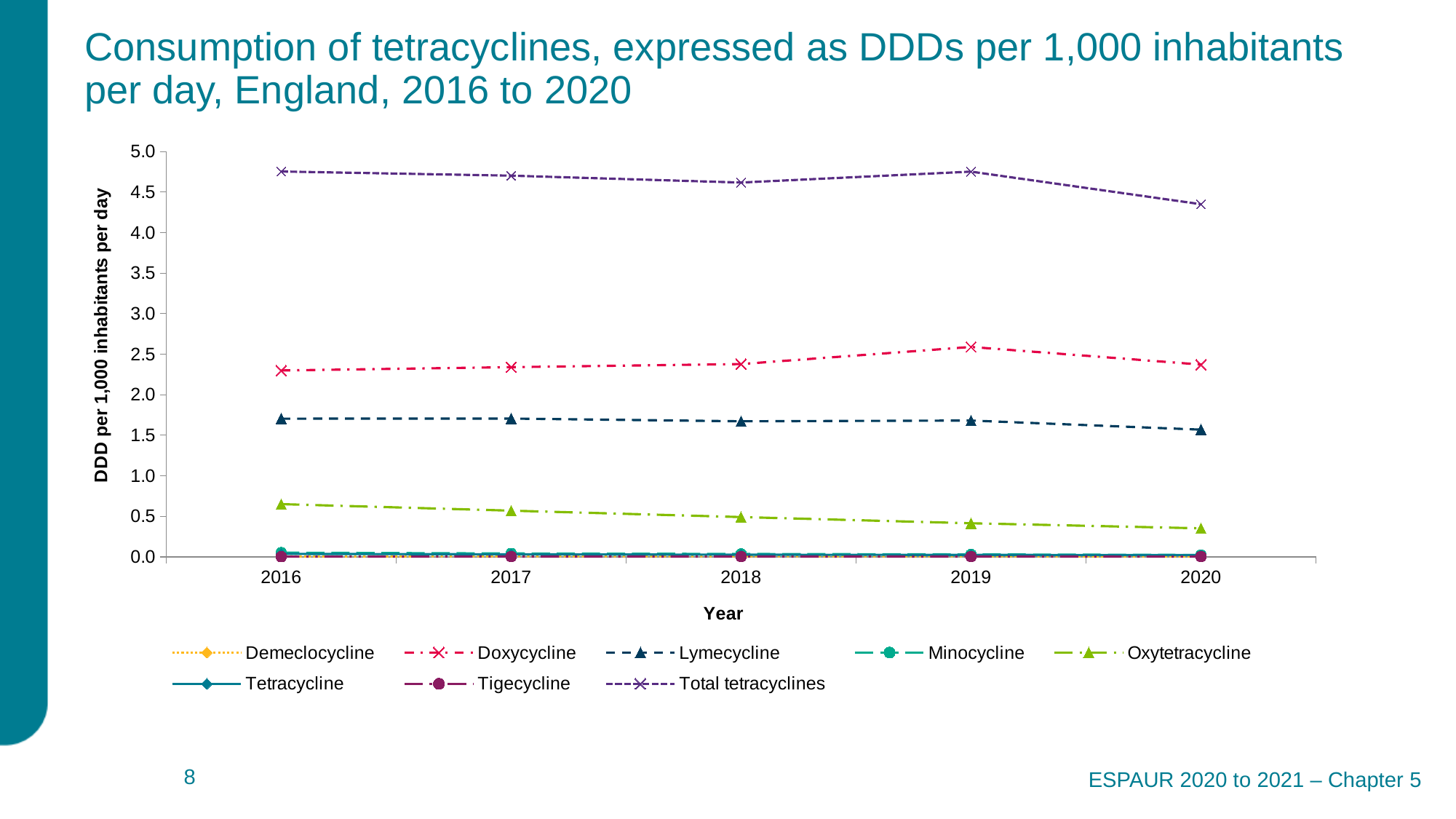
Which series has the highest values across all years? Total tetracyclines In which year is the Total tetracyclines value lowest? 2020 How many series does the legend list? 8 In 2018, which is larger: Lymecycline or Oxytetracycline? Lymecycline Is the Total tetracyclines value for 2020 greater or less than 4.5? less What kind of chart is shown on the slide? line chart Does the Oxytetracycline line rise or fall from 2016 to 2020? fall Is the Total tetracyclines value for 2016 greater or less than 4.5? greater Which individual tetracycline (excluding the total) has the highest consumption in 2019? Doxycycline How many years are plotted along the x axis? 5 Is the Oxytetracycline value for 2016 greater or less than 0.5? greater